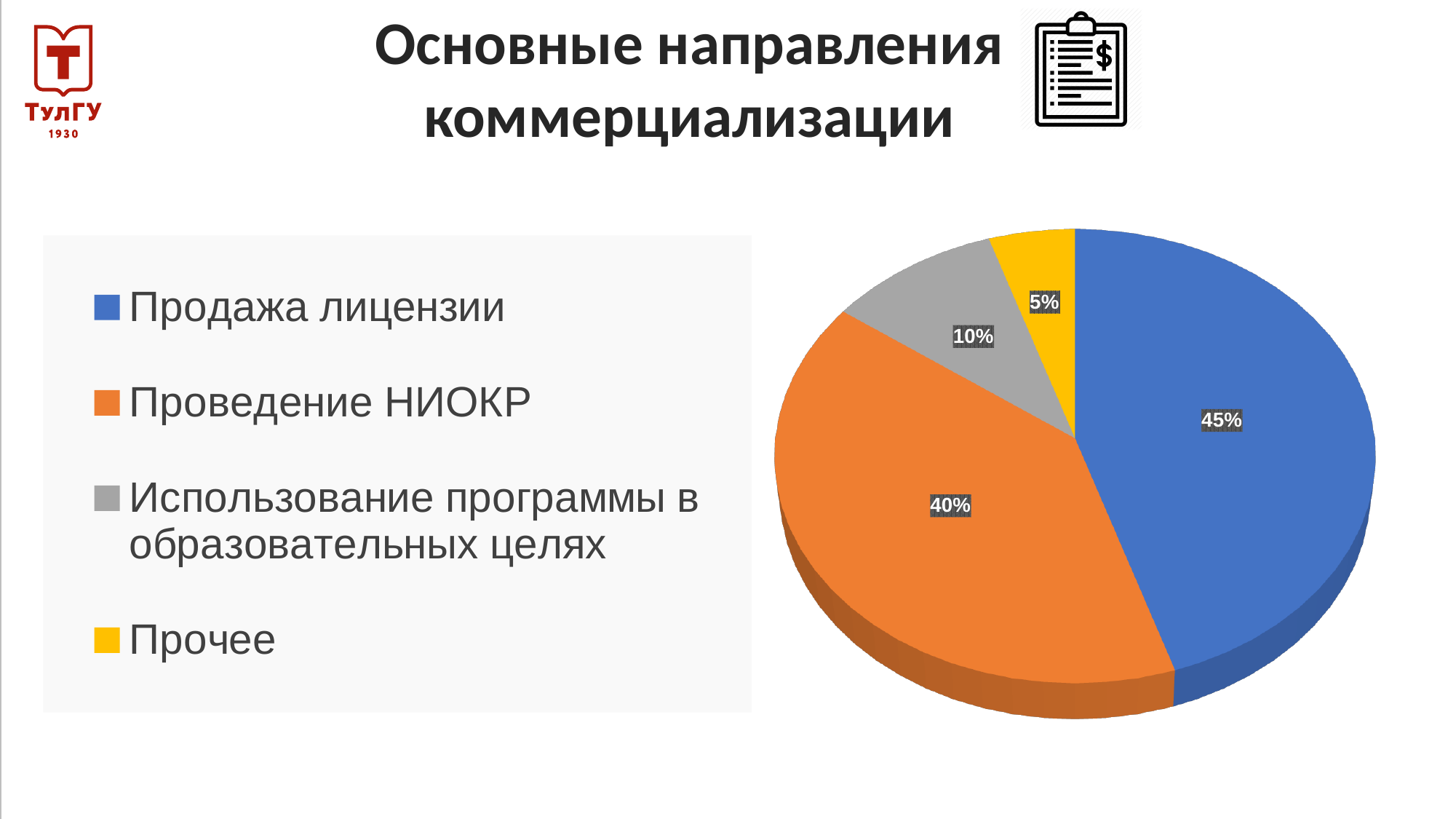
What is the title of the slide containing the pie chart? Основные направления коммерциализации Which category has the smallest slice of the pie? Прочее What colour is the slice for Проведение НИОКР? orange What share of the pie does Проведение НИОКР have? 40% What share of the pie does Использование программы в образовательных целях have? 10% Which category has the largest slice of the pie? Продажа лицензии How many slices does the pie chart have? 4 What is the difference in percentage points between Продажа лицензии and Проведение НИОКР? 5 What kind of chart is shown on the slide? pie chart What share of the pie does Прочее have? 5% What share of the pie does Продажа лицензии have? 45% Which is larger: the slice for Использование программы в образовательных целях or the slice for Прочее? Использование программы в образовательных целях